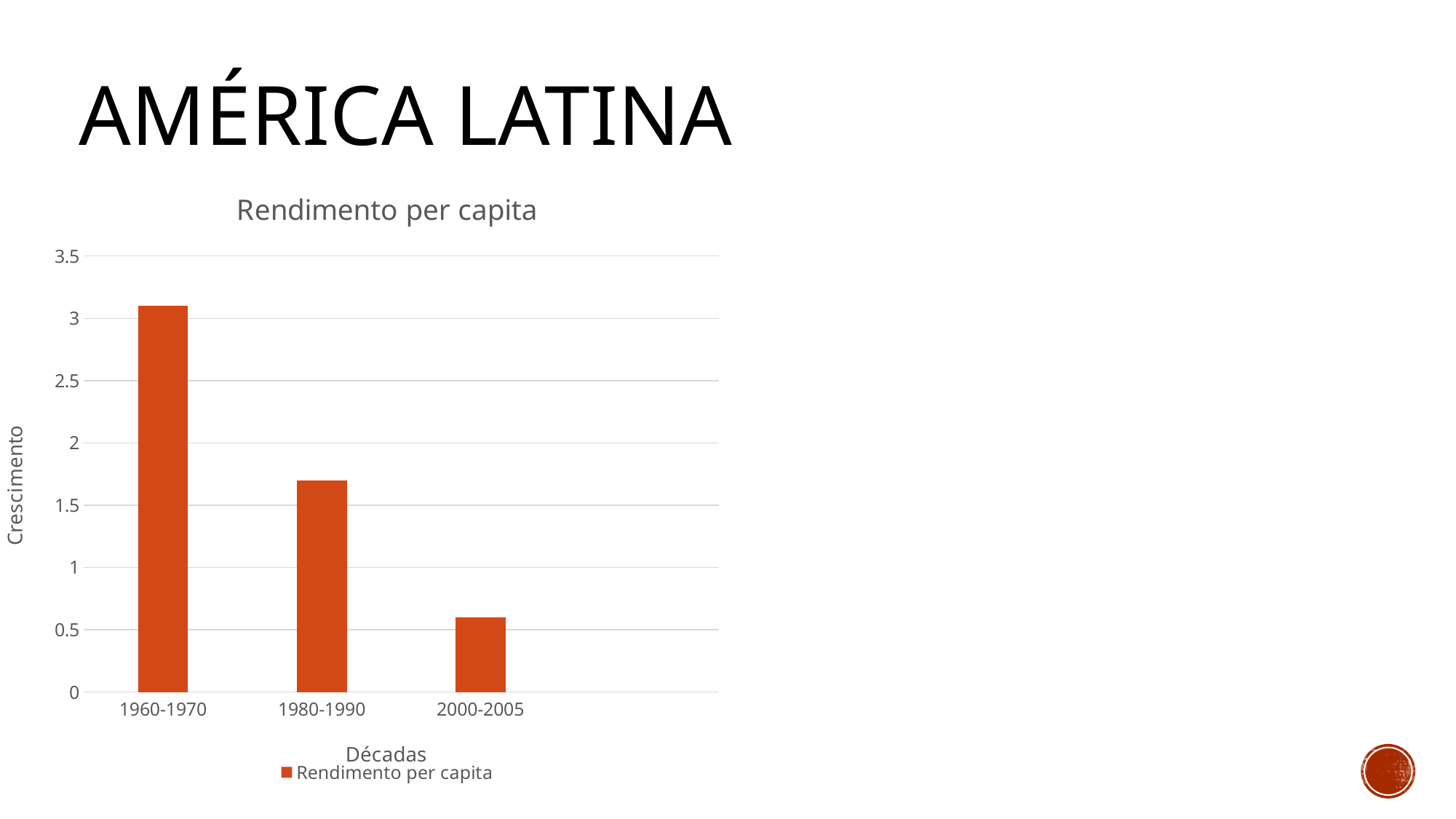
Is the value for 2000-2005 greater or less than 1? less How many series does the legend list? 1 What is the title of the chart? Rendimento per capita Which década has the lowest value? 2000-2005 Is the value for 1980-1990 greater or less than 2? less Which is larger, the value for 1980-1990 or the value for 2000-2005? 1980-1990 What type of chart is shown on the slide? bar chart Do the values rise or fall from 1960-1970 to 2000-2005? fall How many categories (décadas) are shown on the x axis? 3 Is the value for 1980-1990 greater or less than 1.5? greater Which década has the highest value? 1960-1970